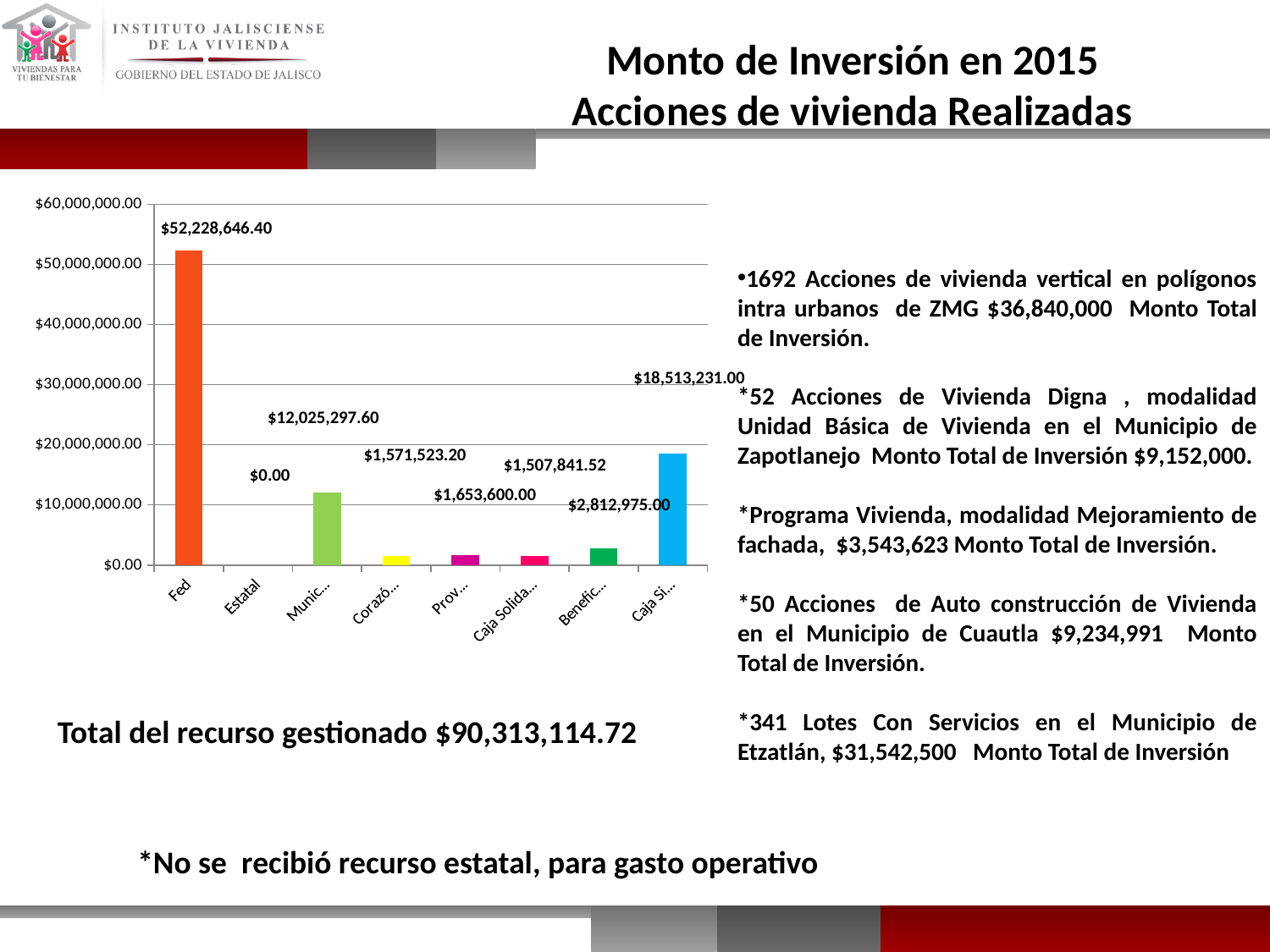
What is the value shown for Fed? $52,228,646.40 What value is labelled on the third bar from the left of the chart? $12,025,297.60 What is the difference between the values for Fed and Estatal? $52,228,646.40 Which category has the highest value in the chart? Fed What is the value shown for Estatal? $0.00 Which category has the lowest value in the chart? Estatal What kind of chart is shown on the slide? bar chart What value is labelled on the rightmost bar of the chart? $18,513,231.00 How many categories are plotted on the x axis of the chart? 8 Is the value for Fed greater or less than $50,000,000.00? greater What colour is the bar for Fed? orange Which is larger, the value for Fed or the value for Estatal? Fed